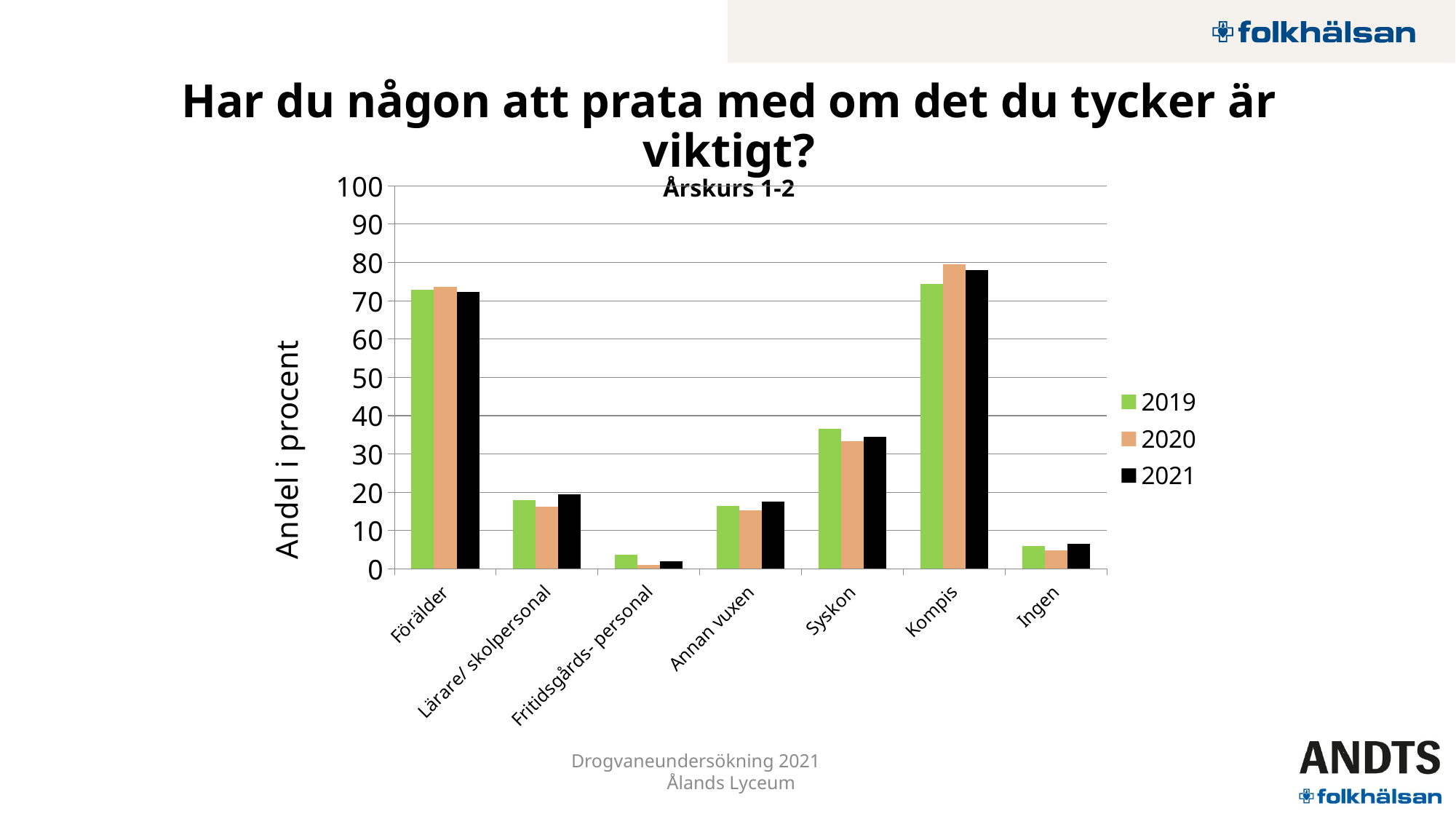
Which is larger for 2020: the value for Kompis or the value for Förälder? Kompis How many series does the legend list? 3 What is the label on the vertical axis of the chart? Andel i procent Is the value for Ingen in 2019 greater or less than 10? less What kind of chart is shown on the slide? bar chart Is the value for Lärare/ skolpersonal in 2021 greater or less than 30? less Which category has the highest value for the 2020 series? Kompis For Syskon, which is larger: the 2019 value or the 2020 value? 2019 How many categories are shown on the x axis of the chart? 7 Is the value for Syskon in 2019 greater or less than 30? greater Which category has the lowest value for the 2019 series? Fritidsgårds- personal